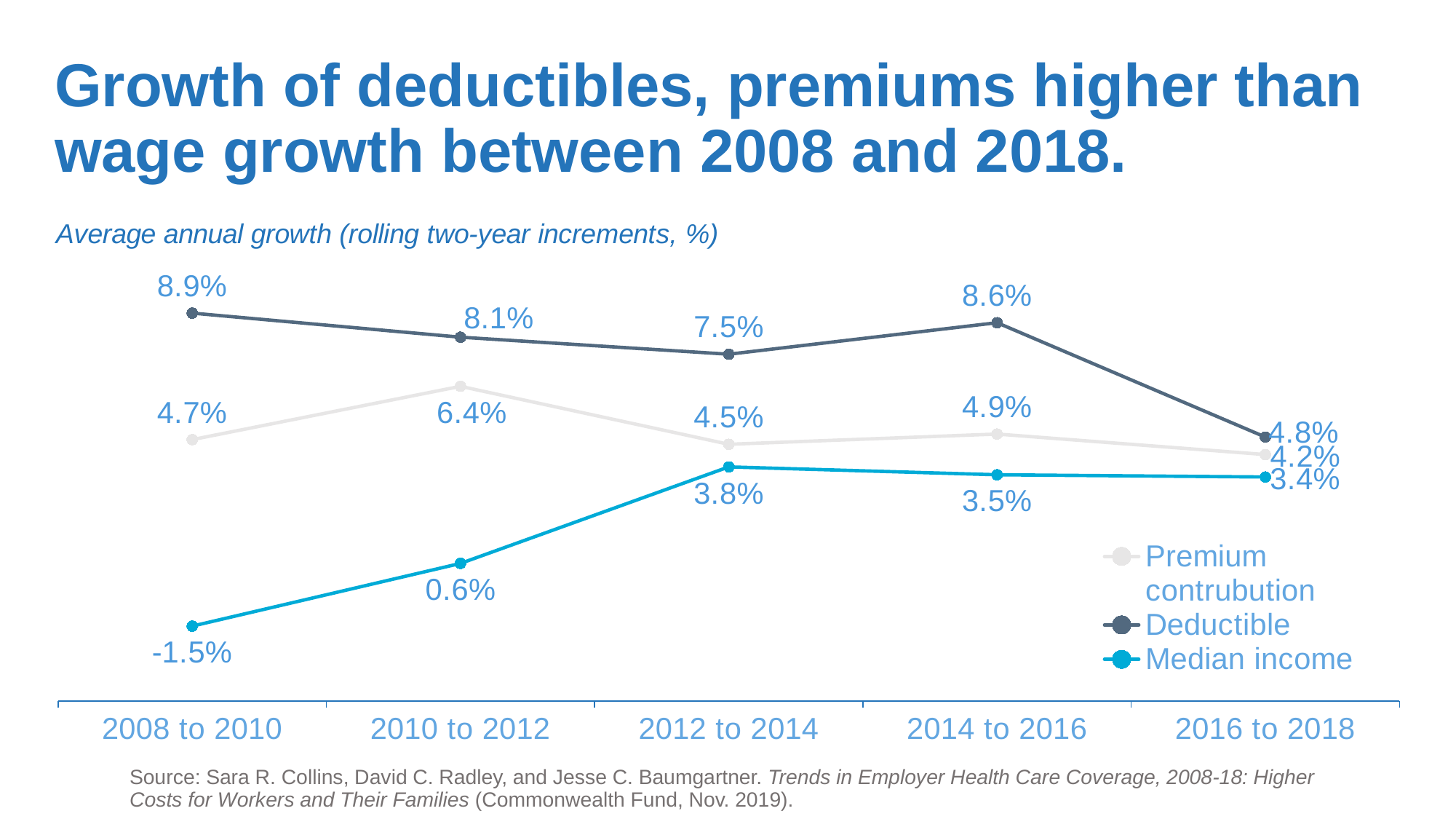
What is the Premium contribution growth value for 2014 to 2016? 4.9% How many time periods are shown on the x axis? 5 Does the Deductible growth rise or fall between 2014 to 2016 and 2016 to 2018? Fall Which is larger for 2016 to 2018, the Deductible growth or the Premium contribution growth? Deductible What is the difference between the Deductible growth and the Premium contribution growth for 2012 to 2014? 3.0% How many series does the legend list? 3 What is the Median income growth value for 2010 to 2012? 0.6% In which period is the Median income growth lowest? 2008 to 2010 What is the subtitle of the chart describing the measure plotted? Average annual growth (rolling two-year increments, %) What type of chart is shown on the slide? Line chart In which period is the Deductible growth highest? 2008 to 2010 What is the Deductible growth value for 2008 to 2010? 8.9%